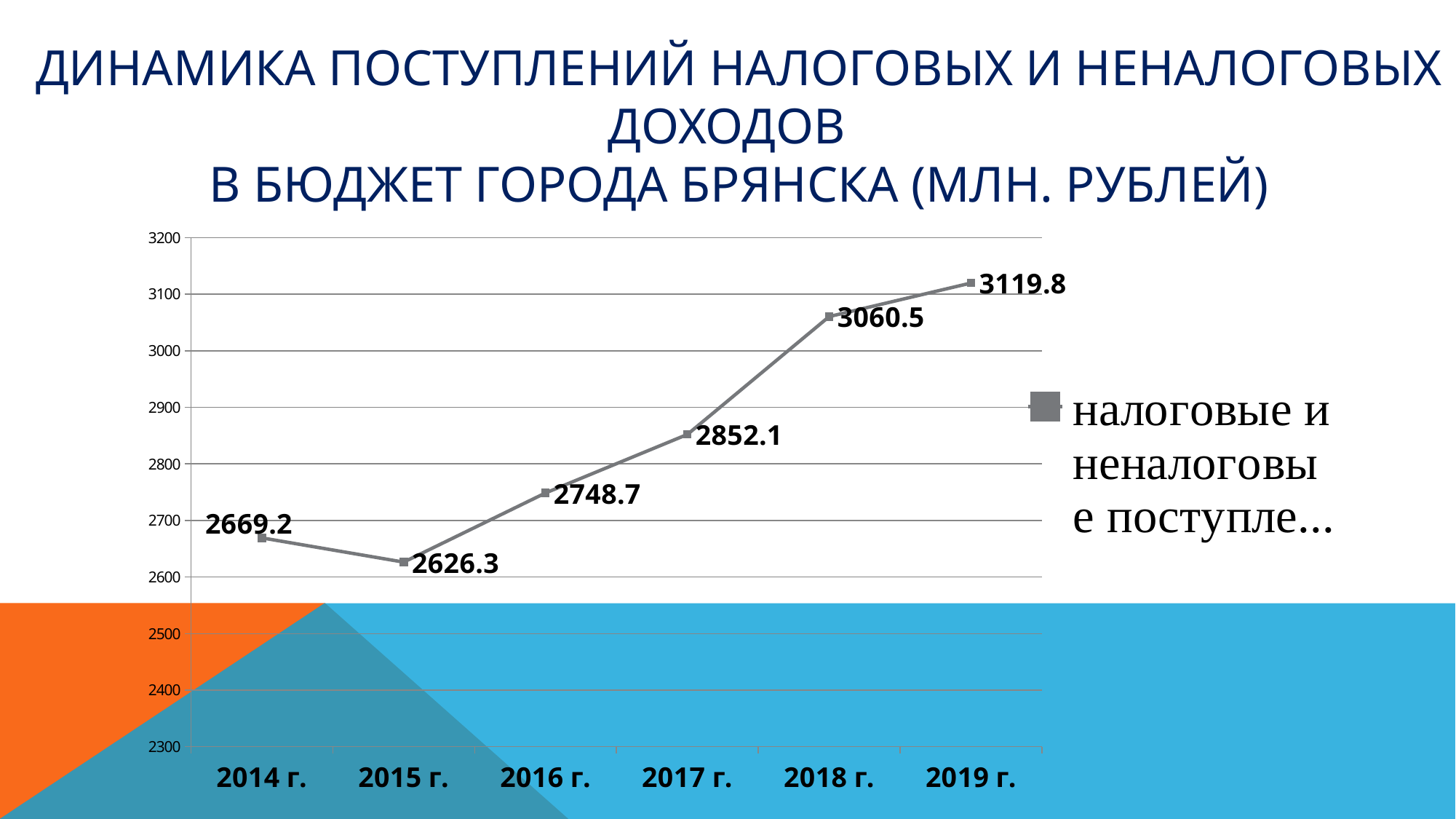
Which is larger, the value for 2014 г. or the value for 2015 г.? 2014 г. What type of chart is shown on the slide? line chart Which year has the lowest value? 2015 г. Is the value for 2016 г. greater or less than 2700? greater What is the value for 2019 г.? 3119.8 Which year has the highest value? 2019 г. What is the value for 2017 г.? 2852.1 What is the difference between the values for 2019 г. and 2014 г.? 450.6 What is the value for 2014 г.? 2669.2 Does the value rise or fall from 2015 г. to 2019 г.? rise How many years are plotted on the x axis? 6 What is the difference between the values for 2018 г. and 2017 г.? 208.4